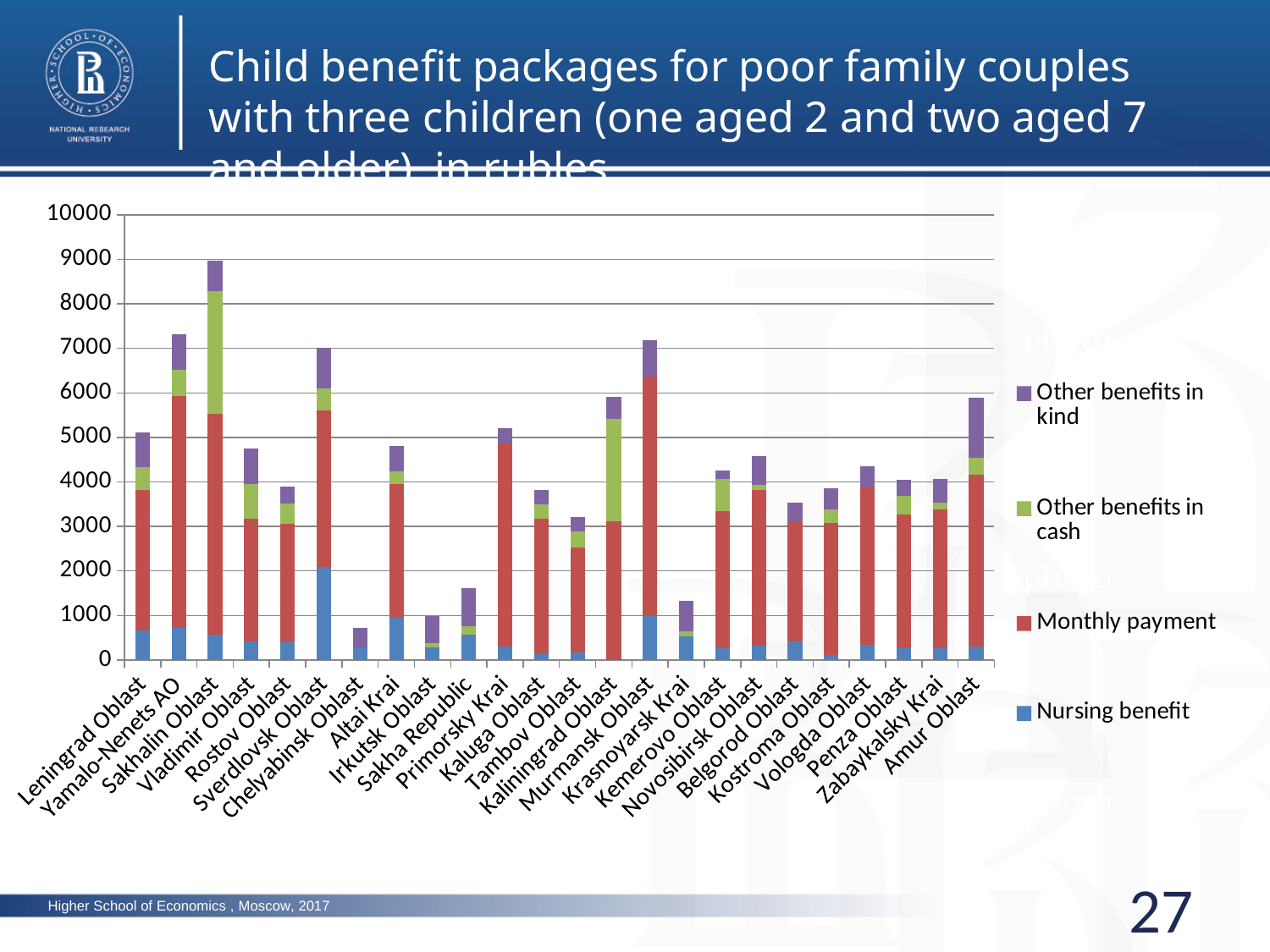
Which region has the highest total child benefit package? Sakhalin Oblast Is the total for Sakhalin Oblast greater or less than 8000? greater How many series does the legend list? 4 Is the total for Krasnoyarsk Krai greater or less than 2000? less How many regions are shown on the x axis? 24 Which colour represents Monthly payment in the legend? Red Is the total for Chelyabinsk Oblast greater or less than 1000? less What kind of chart is shown on the slide? Stacked bar chart Which is larger, the total for Sakhalin Oblast or the total for Yamalo-Nenets AO? Sakhalin Oblast Which region has the lowest total child benefit package? Chelyabinsk Oblast Which region has the largest Nursing benefit component? Sverdlovsk Oblast